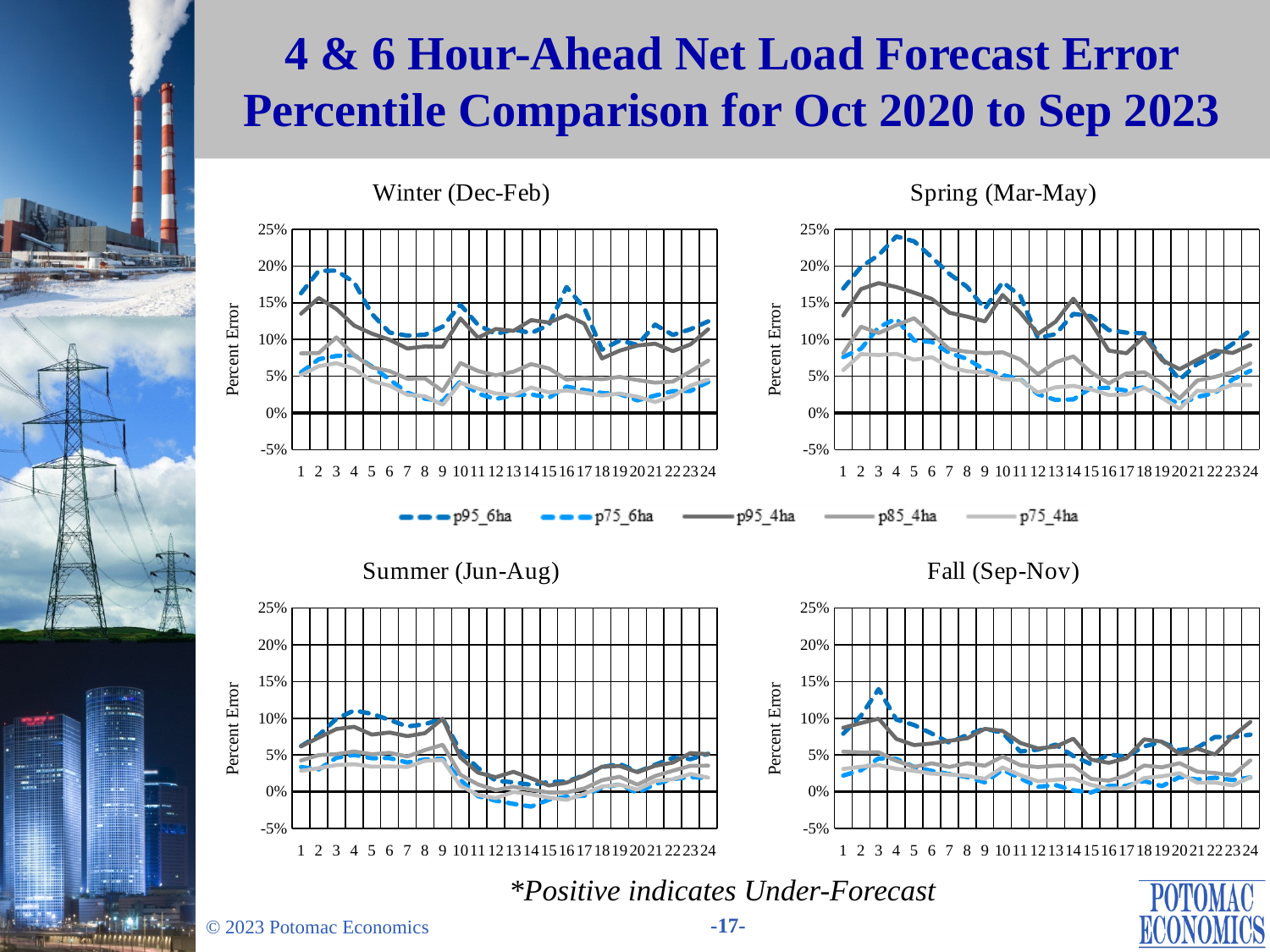
In the Summer (Jun-Aug) chart, is the p95_6ha value at hour 15 greater or less than 5%? less In the Fall (Sep-Nov) chart, is the p95_6ha value at hour 3 greater or less than 10%? greater In the Spring (Mar-May) chart, is the p95_6ha value at hour 4 greater or less than 20%? greater How many series does the shared legend list? 5 How many hour points are plotted along the x axis of the Summer (Jun-Aug) chart? 24 What kind of chart is the Winter (Dec-Feb) chart? line chart What is the y-axis label on the Fall (Sep-Nov) chart? Percent Error In the Summer (Jun-Aug) chart, does the p95_6ha line rise or fall from hour 9 to hour 15? fall Which of the four seasonal charts shows the highest peak value for p95_6ha? Spring (Mar-May)